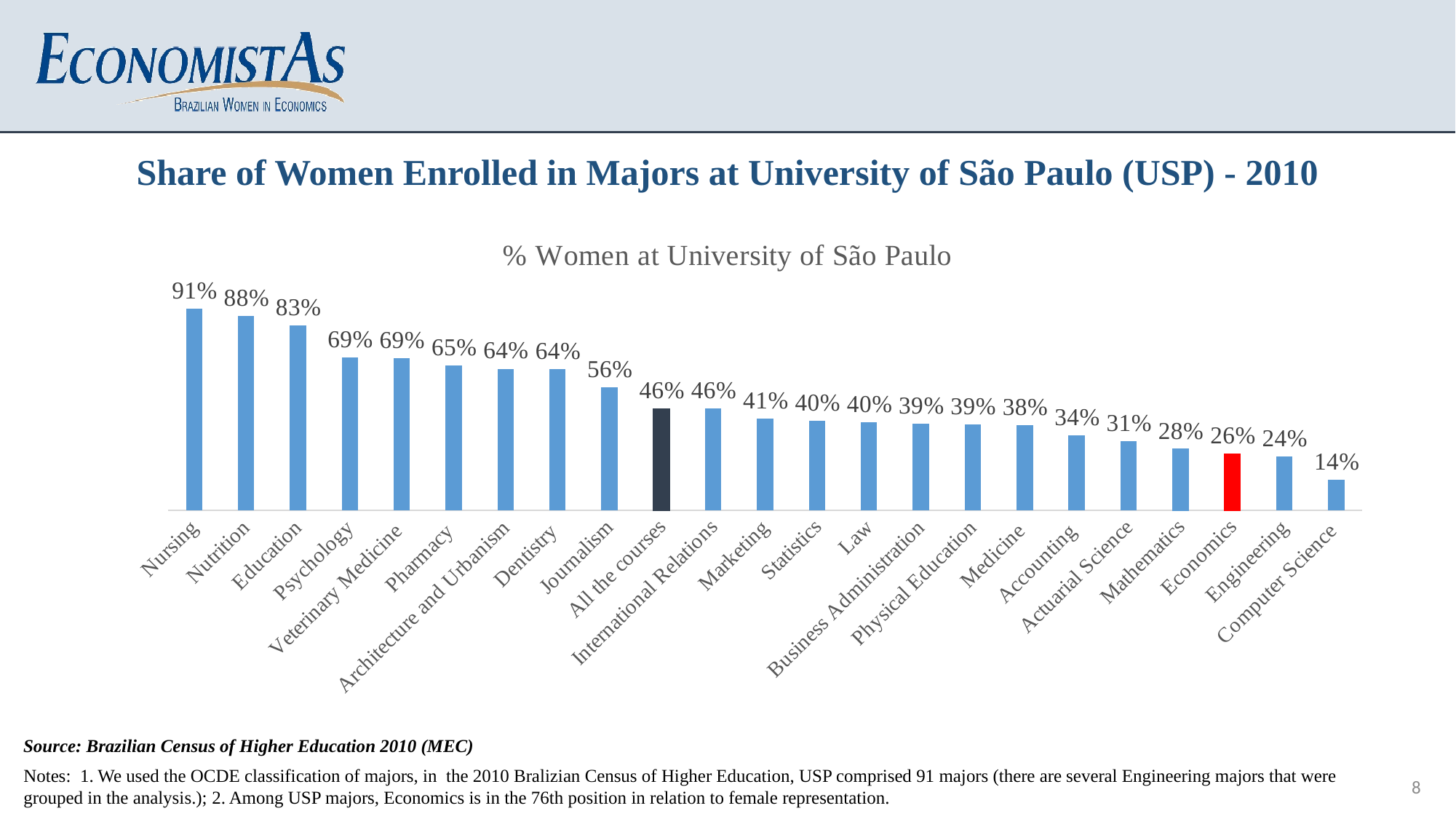
How many categories are shown in the chart? 23 What is the value for Nursing? 91% What kind of chart is shown on the slide? Bar chart What is the value for Medicine? 38% What is the value for Economics? 26% What is the difference between the values for Nursing and Computer Science? 77% Which is larger, the value for Journalism or the value for Marketing? Journalism What is the value for All the courses? 46% What is the difference between the values for All the courses and Economics? 20% Which category's bar is coloured red? Economics Which category has the lowest value? Computer Science Which category has the highest value? Nursing